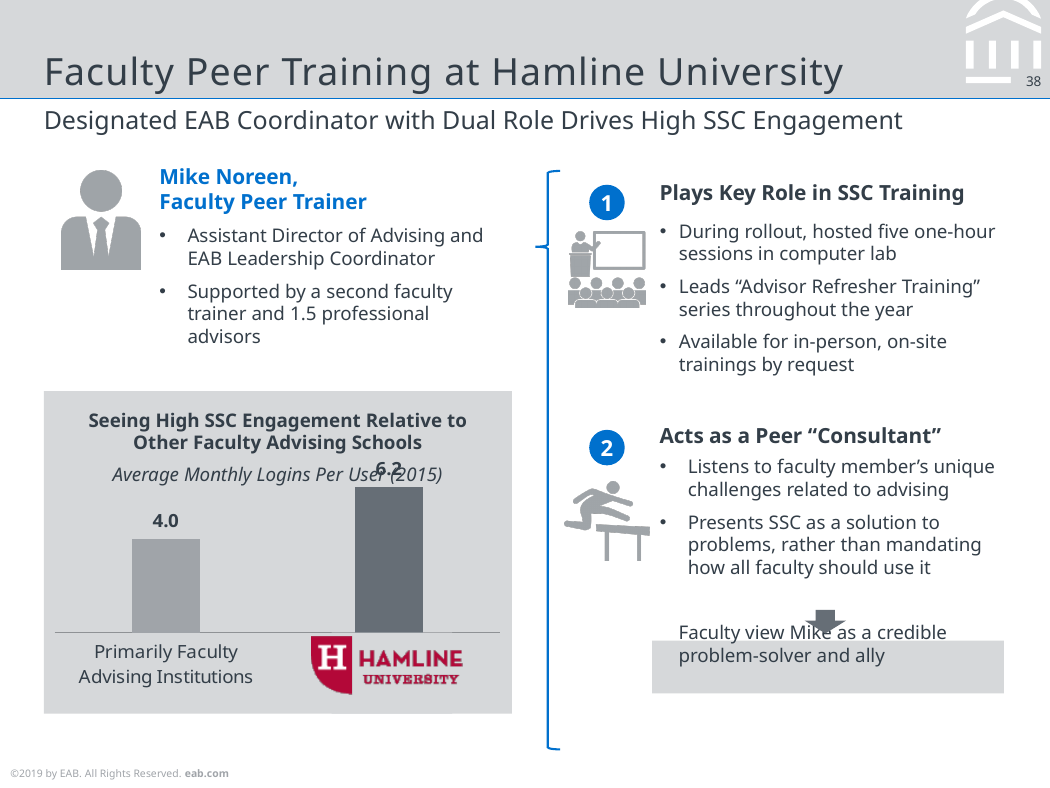
Which category has the higher average monthly logins per user? Hamline University What is the average monthly logins per user for Hamline University? 6.2 What is the title of the chart? Seeing High SSC Engagement Relative to Other Faculty Advising Schools What is the difference in average monthly logins per user between Hamline University and Primarily Faculty Advising Institutions? 2.2 How many bars are shown in the chart? 2 What metric does the chart's subtitle say is plotted? Average Monthly Logins Per User (2015) What is the average monthly logins per user for Primarily Faculty Advising Institutions? 4.0 Which category has the lower average monthly logins per user? Primarily Faculty Advising Institutions What type of chart is shown on the slide? bar chart Is the value for Hamline University larger or smaller than the value for Primarily Faculty Advising Institutions? larger